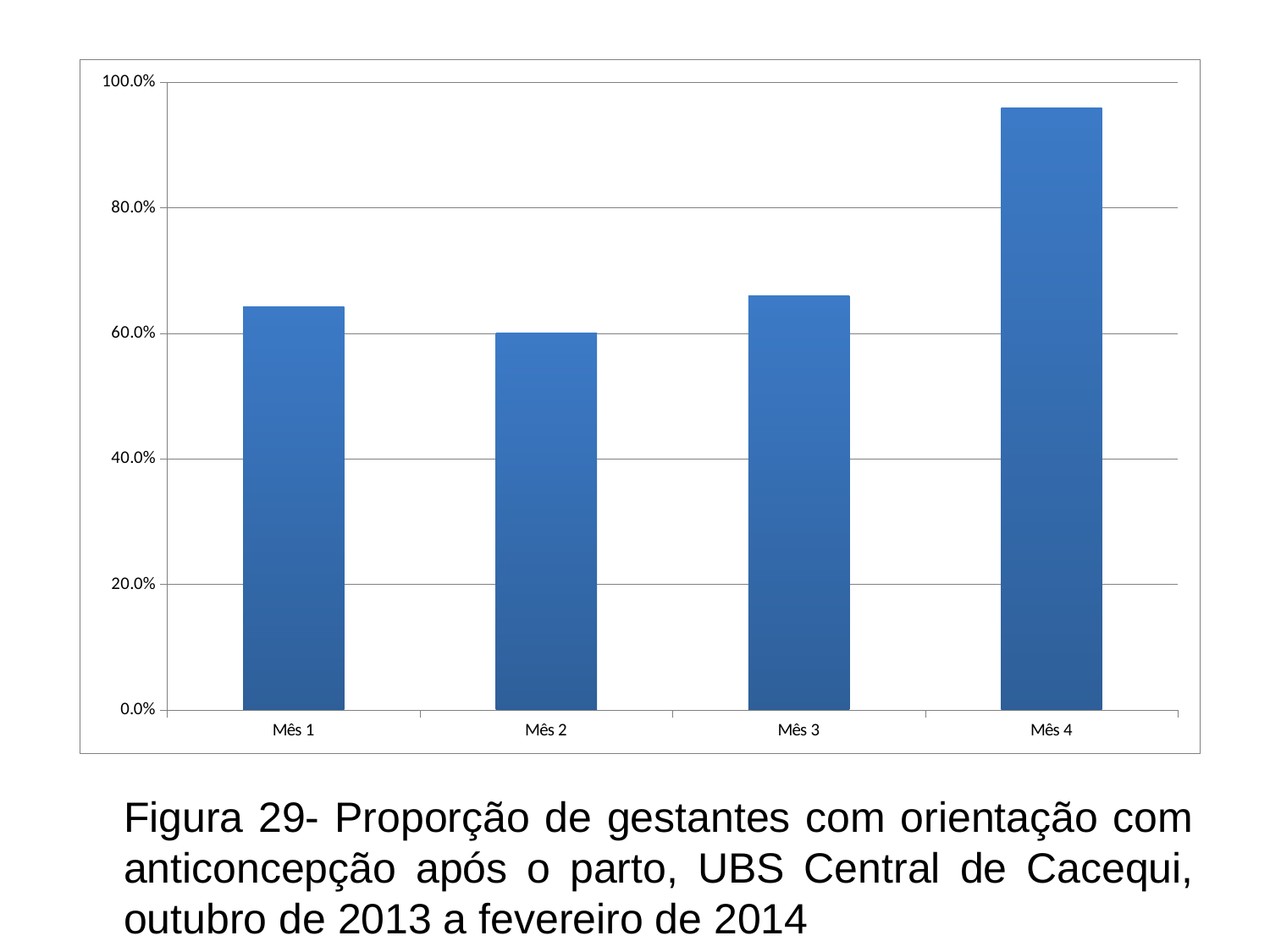
Is the value for Mês 3 greater or less than 60.0%? greater Is the value for Mês 2 greater or less than 40.0%? greater How many months (categories) are plotted on the x axis? 4 Is the value for Mês 1 greater or less than 80.0%? less Which is larger, the value for Mês 4 or the value for Mês 1? Mês 4 Does the value rise or fall from Mês 3 to Mês 4? rise What figure number is given in the caption below the chart? Figura 29 Which month has the highest value? Mês 4 Which is larger, the value for Mês 3 or the value for Mês 2? Mês 3 Which month has the lowest value? Mês 2 What kind of chart is shown on the slide? bar chart